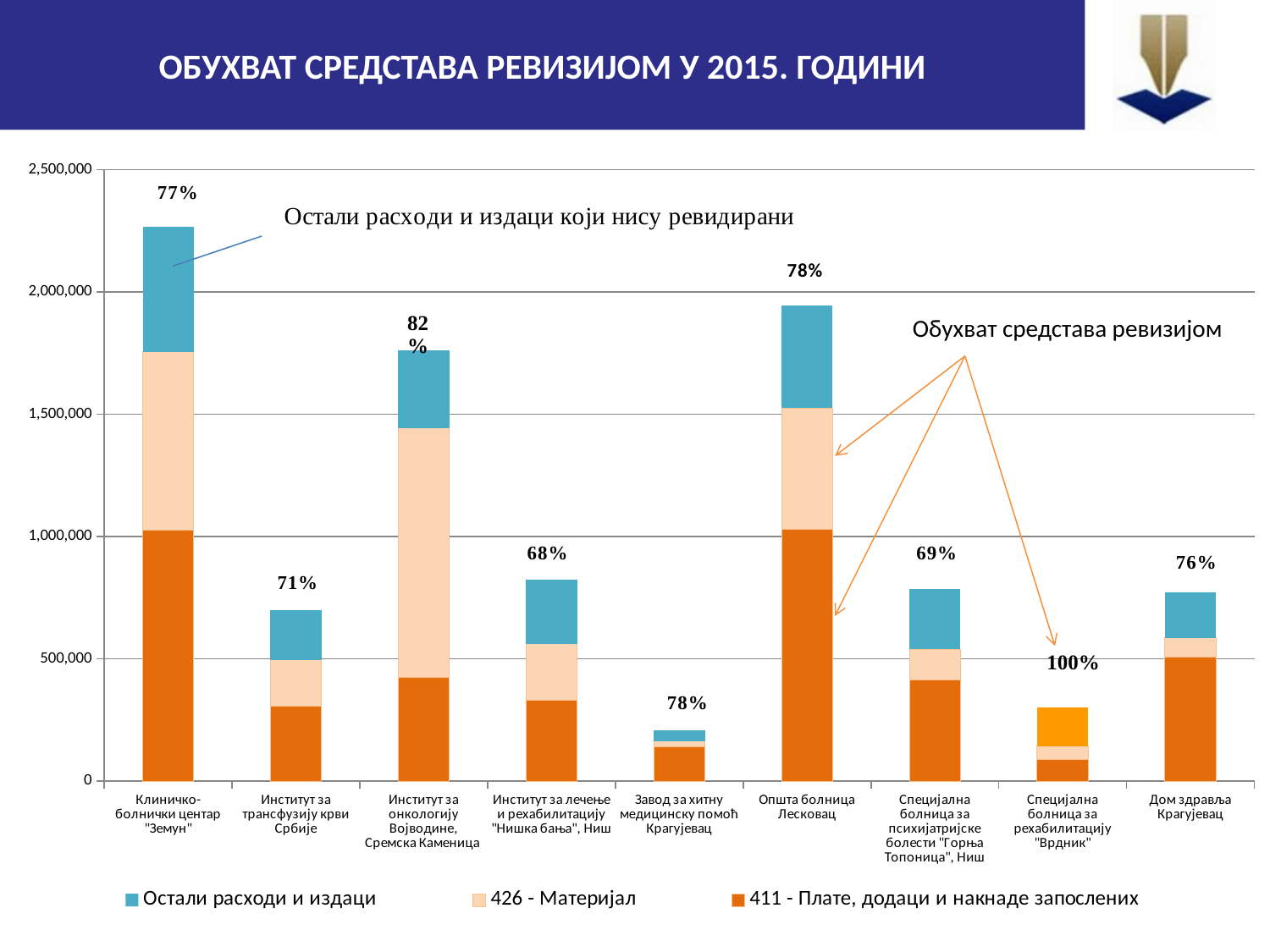
How many series does the legend list? 3 Which institution has the lowest percentage printed above its bar? Институт за лечење и рехабилитацију "Нишка бања", Ниш What percentage is printed above the bar for Специјална болница за рехабилитацију "Врдник"? 100% Is the total bar height for Завод за хитну медицинску помоћ Крагујевац greater or less than 500,000? less Is the total bar height for Клиничко-болнички центар "Земун" greater or less than 2,000,000? greater What is the title of the chart on the slide? ОБУХВАТ СРЕДСТАВА РЕВИЗИЈОМ У 2015. ГОДИНИ Which institution has the highest percentage printed above its bar? Специјална болница за рехабилитацију "Врдник" What kind of chart is shown on the slide? bar chart Which has the taller total bar: Клиничко-болнички центар "Земун" or Општа болница Лесковац? Клиничко-болнички центар "Земун" What percentage is printed above the bar for Институт за трансфузију крви Србије? 71% What percentage is printed above the bar for Општа болница Лесковац? 78% How many institutions (categories) are shown on the x axis? 9